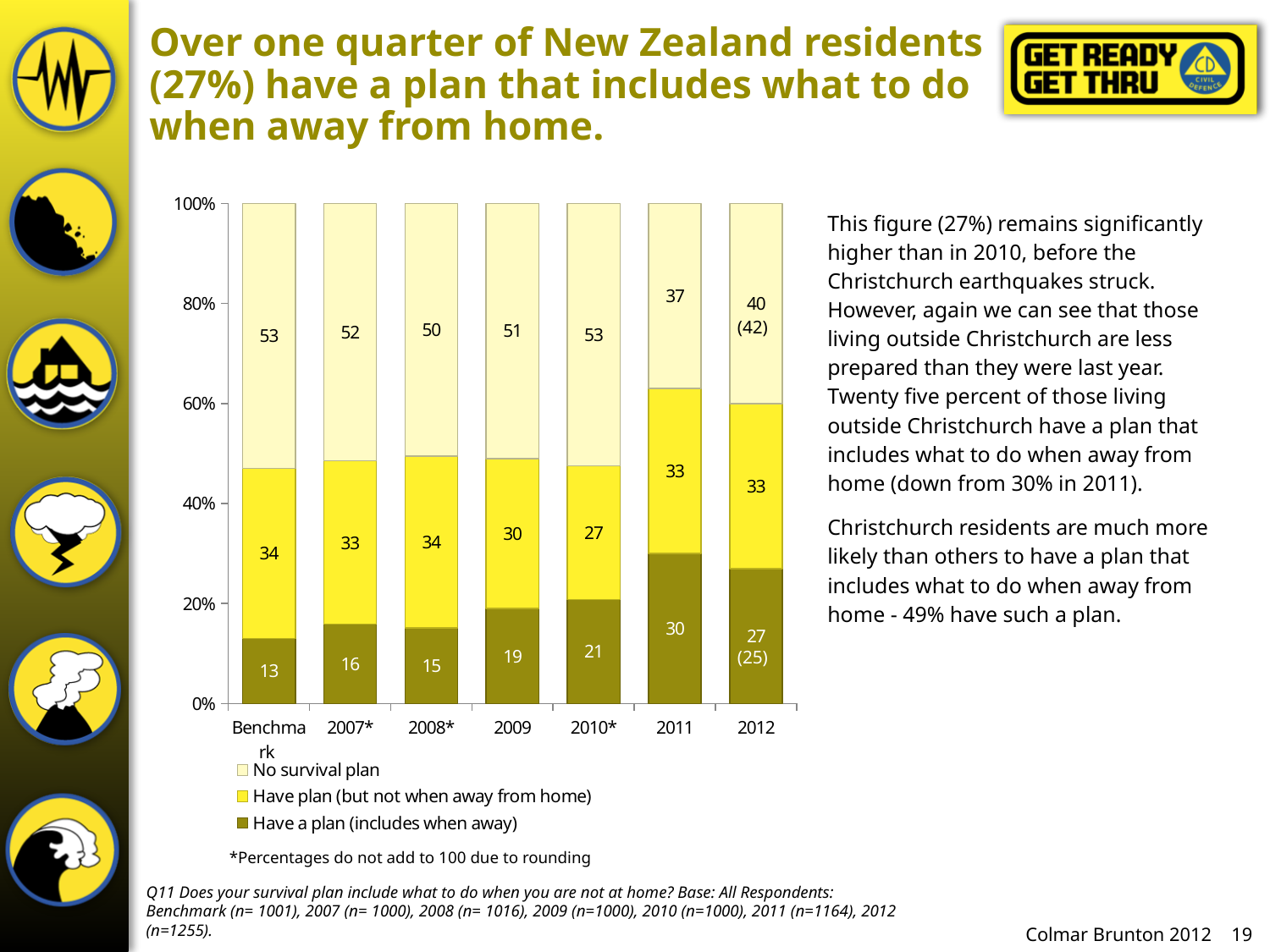
Which series is shown in the darkest colour at the bottom of each bar? Have a plan (includes when away) How many series does the legend list? 3 Which year has the highest value for 'Have a plan (includes when away)'? 2011 Which category has the lowest value for 'Have a plan (includes when away)'? Benchmark Which is larger: the 'Have a plan (includes when away)' value in 2009 or in 2012? 2012 How many categories are shown along the x axis? 7 What is the value for 'No survival plan' in the Benchmark category? 53 What is the value for 'Have a plan (includes when away)' in 2011? 30 What is the difference between the 'No survival plan' values for 2010* and 2011? 16 Do the 'Have a plan (includes when away)' values generally rise or fall from Benchmark to 2011? Rise What is the value for 'Have plan (but not when away from home)' in 2010*? 27 What kind of chart is shown on the slide? Stacked bar chart